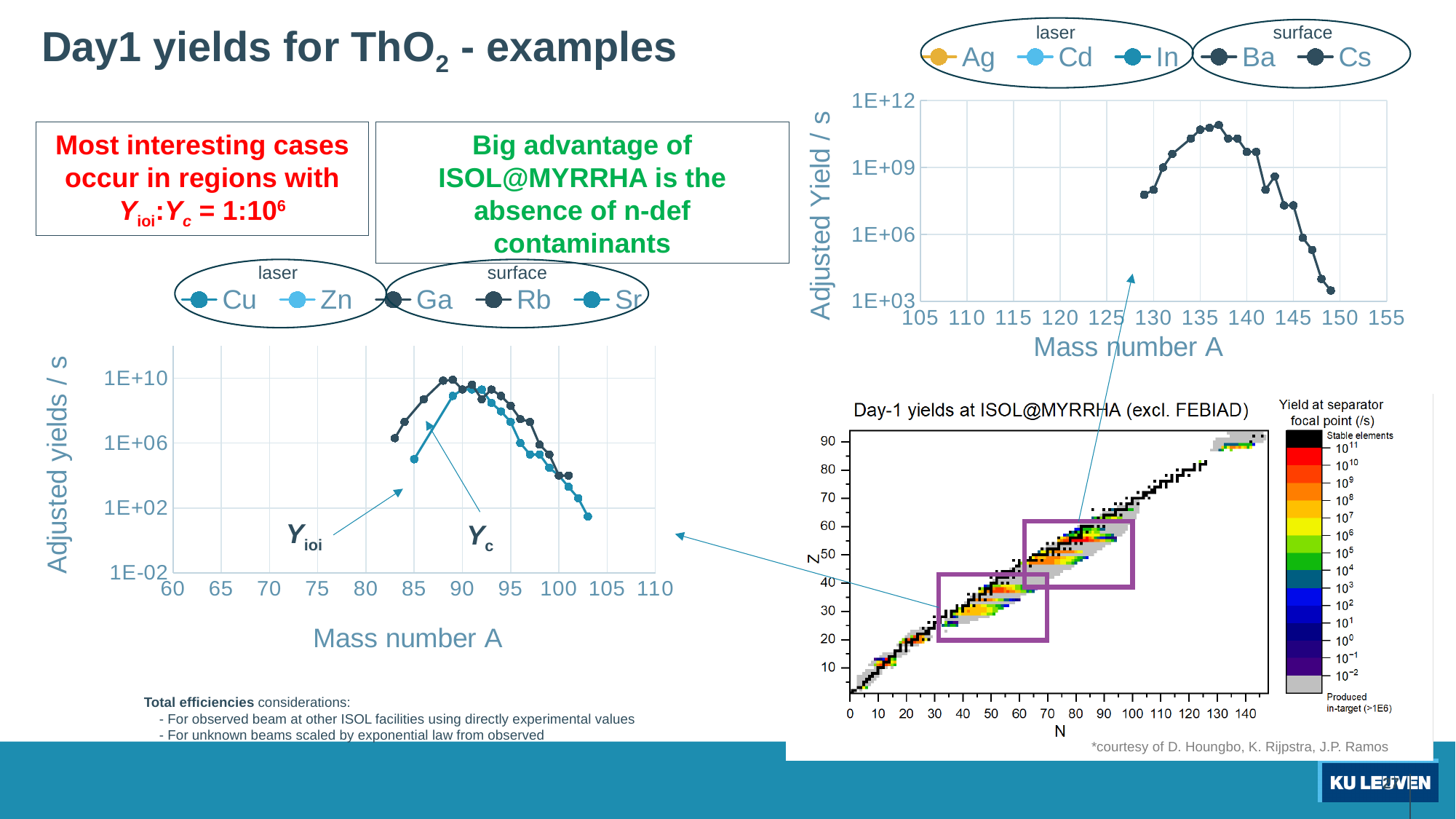
What kind of chart is the chart on the left with x axis 'Mass number A' from 60 to 110? line chart What is the title of the x axis of the top-right chart? Mass number A How many series does the legend of the top-right chart (Ag, Cd, In, Ba, Cs) list? 5 In the top-right chart, is the value at mass number 150 greater or less than 1E+06? less In the top-right chart, is the highest plotted value (near mass number 136) greater or less than 1E+09? greater How many series does the legend of the left chart (Cu, Zn, Ga, Rb, Sr) list? 5 In the left chart, is the highest plotted value (near mass number 89) greater or less than 1E+06? greater In the top-right chart, do the values rise or fall as mass number A goes from 129 to 135? rise In the top-right chart, do the values rise or fall as mass number A goes from 140 to 150? fall In the left chart, do the values rise or fall as mass number A goes from 92 to 103? fall What is the title of the nuclear chart image at the bottom right? Day-1 yields at ISOL@MYRRHA (excl. FEBIAD)